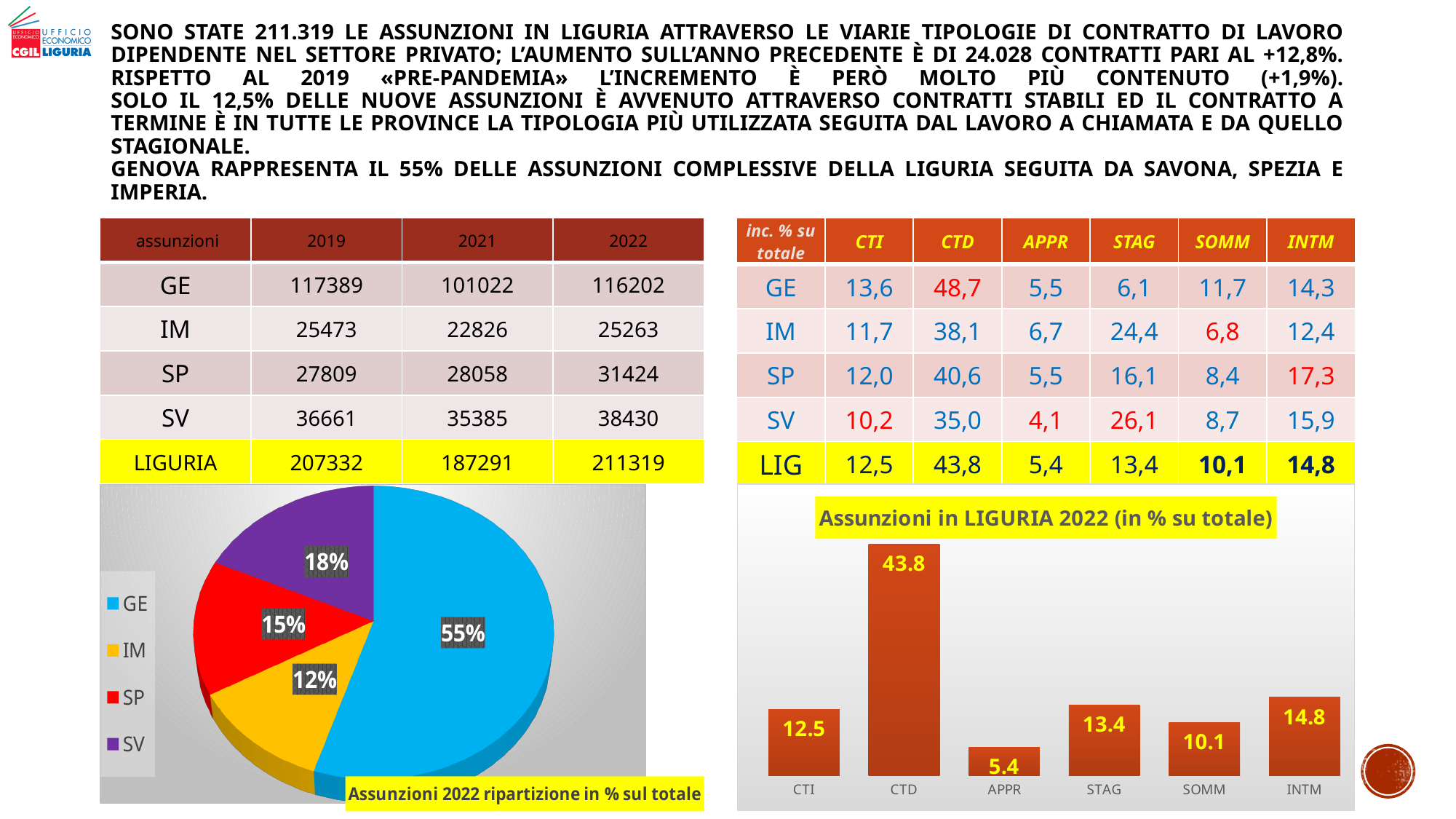
In the bar chart 'Assunzioni in LIGURIA 2022 (in % su totale)', what is the value for CTD? 43.8 How many categories does the legend of the pie chart 'Assunzioni 2022 ripartizione in % sul totale' list? 4 In the bar chart 'Assunzioni in LIGURIA 2022 (in % su totale)', what is the difference between INTM and SOMM? 4.7 In the pie chart 'Assunzioni 2022 ripartizione in % sul totale', what share does GE have? 55% What type of chart is 'Assunzioni in LIGURIA 2022 (in % su totale)'? Bar chart How many bars are shown in the bar chart 'Assunzioni in LIGURIA 2022 (in % su totale)'? 6 In the bar chart 'Assunzioni in LIGURIA 2022 (in % su totale)', which category has the highest value? CTD In the pie chart 'Assunzioni 2022 ripartizione in % sul totale', what is the value for SV? 18% In the bar chart 'Assunzioni in LIGURIA 2022 (in % su totale)', which category has the lowest value? APPR In the pie chart 'Assunzioni 2022 ripartizione in % sul totale', which category has the smallest slice? IM In the pie chart 'Assunzioni 2022 ripartizione in % sul totale', which is larger, SP or SV? SV What type of chart is 'Assunzioni 2022 ripartizione in % sul totale'? Pie chart